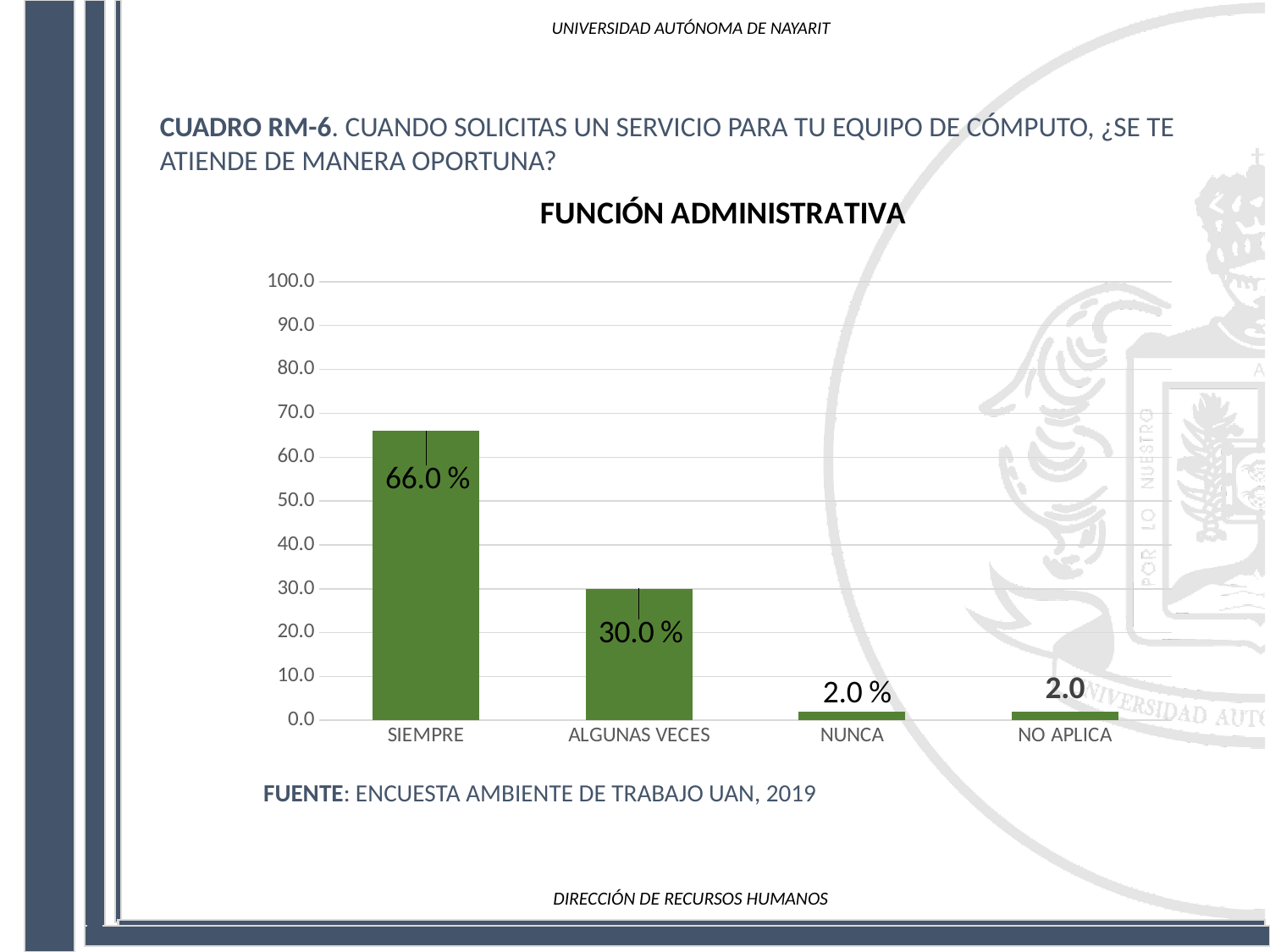
What is the data label shown on the NO APLICA bar? 2.0 Which category has the highest value? SIEMPRE How many categories are shown on the x axis? 4 Is the value for ALGUNAS VECES greater or less than 40.0? less What is the value for ALGUNAS VECES? 30.0 % What is the value for NUNCA? 2.0 % Do the values rise or fall from SIEMPRE to NUNCA along the x axis? fall Which is larger, the value for ALGUNAS VECES or the value for NUNCA? ALGUNAS VECES What type of chart is shown on the slide? bar chart What is the value for SIEMPRE? 66.0 % What is the title of the chart? FUNCIÓN ADMINISTRATIVA What is the difference between the values for SIEMPRE and ALGUNAS VECES? 36.0 %